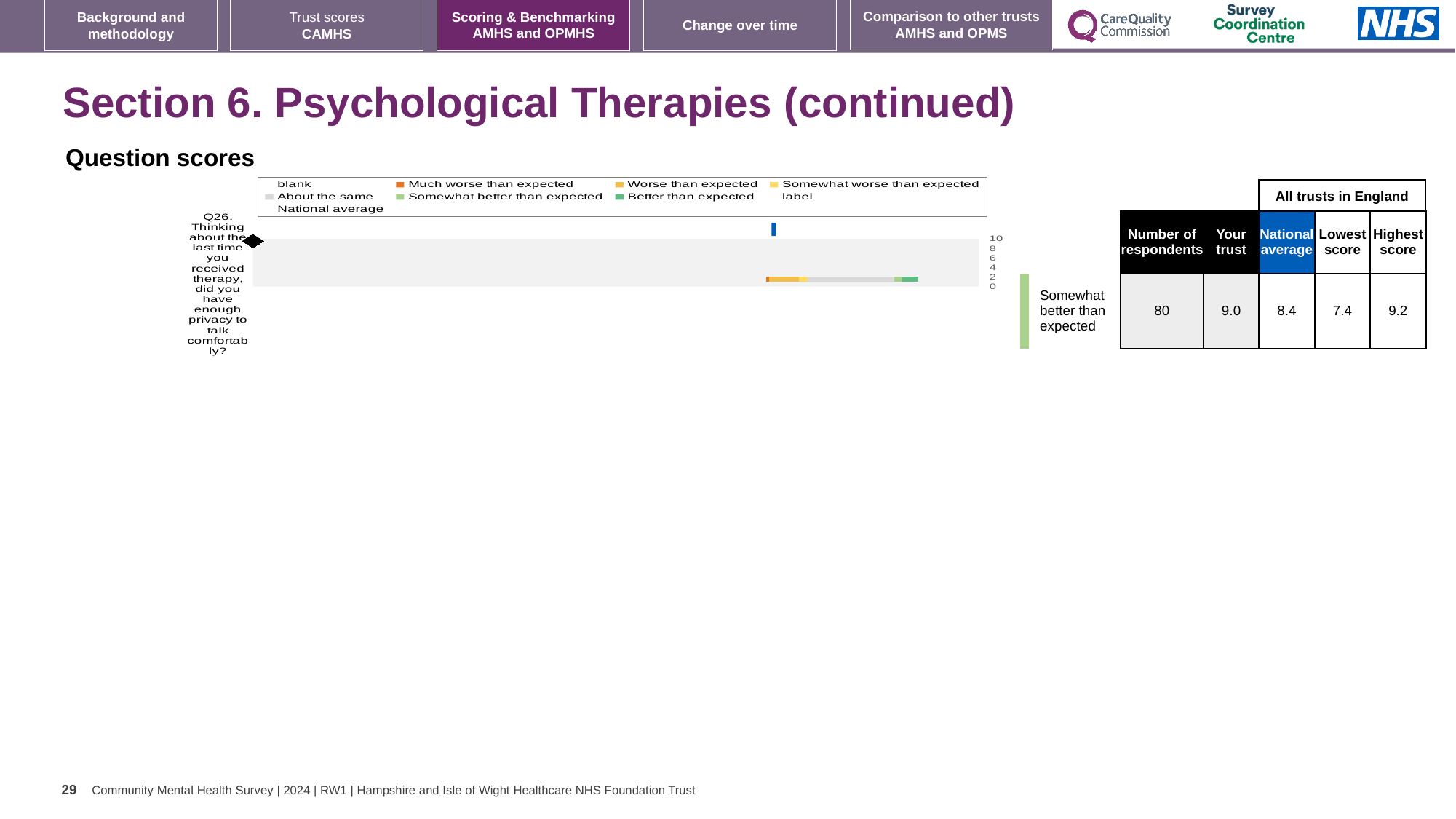
What benchmark category is the trust's Q26 score placed in, as labelled to the right of the chart? Somewhat better than expected Which question number is plotted in the chart? Q26 According to the table beside the chart, what is the national average score for Q26? 8.4 According to the table beside the chart, what is the lowest score among all trusts in England for Q26? 7.4 How many questions (categories) are plotted in the chart? 1 What is the highest value shown on the chart's score axis? 10 Which is larger for Q26: the trust's score or the national average? the trust's score What is the difference between the trust's score and the national average for Q26? 0.6 What kind of chart is shown under 'Question scores'? bar chart According to the table beside the chart, what is the 'Your trust' score for Q26? 9.0 According to the table beside the chart, what is the highest score among all trusts in England for Q26? 9.2 How many respondents answered Q26, according to the table beside the chart? 80